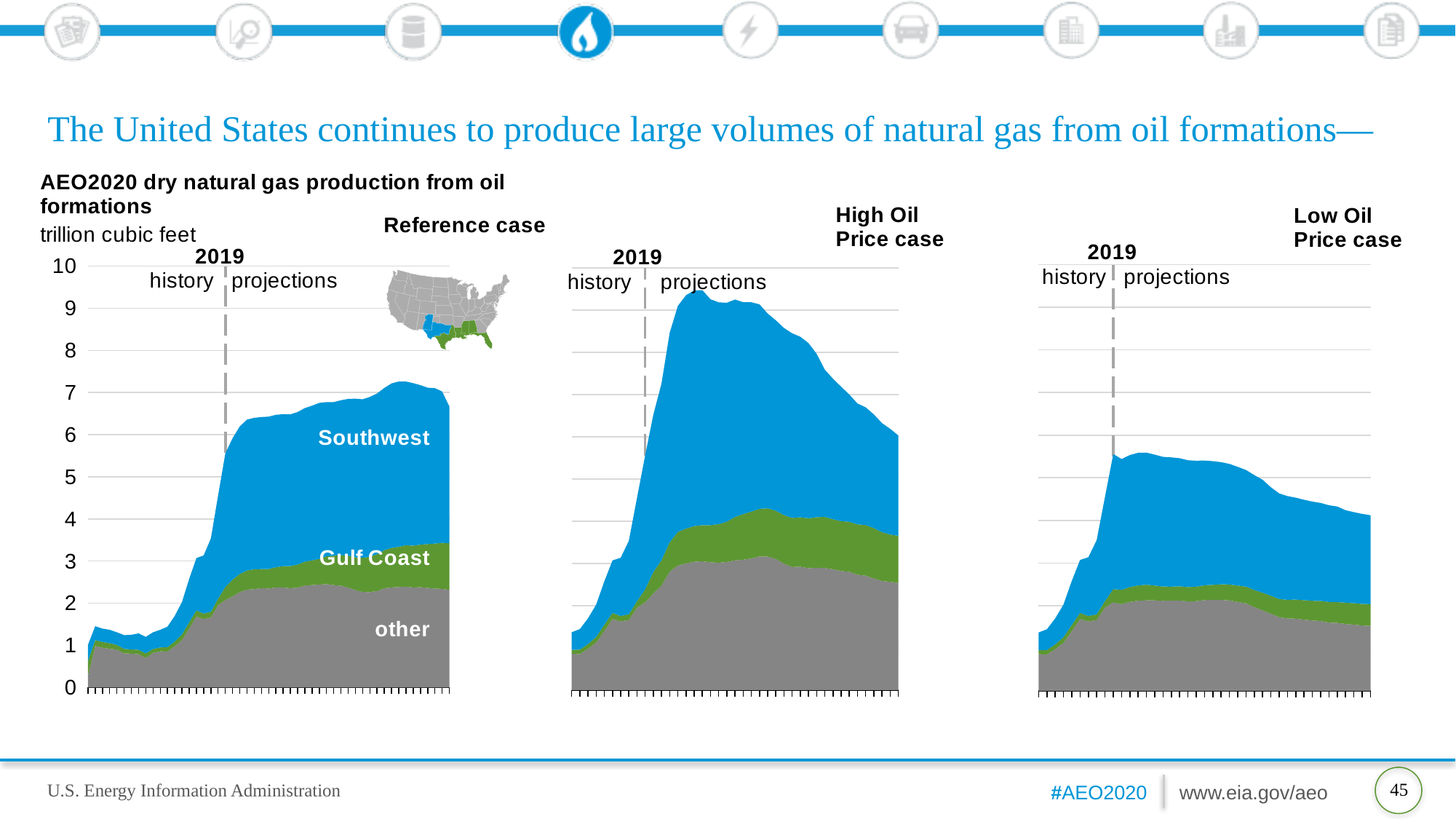
What kind of chart is used for the Reference case on this slide? stacked area chart How many series are stacked in each chart on this slide? 3 Which of the three cases has the lowest peak total production? Low Oil Price case In the Low Oil Price case chart, is the total production at the end of the projection period greater or less than 5 trillion cubic feet? less In the Low Oil Price case chart, is the peak total production greater or less than 6 trillion cubic feet? less What unit is shown on the y axis of the charts? trillion cubic feet In the Reference case chart, which series forms the bottom (grey) layer of the stack? other In the Low Oil Price case chart, does total production rise or fall over the projection period after 2019? fall In the High Oil Price case chart, does total production rise or fall after its peak in the projection period? fall Which of the three cases reaches the highest peak total production? High Oil Price case In the Reference case chart, is the peak total production greater or less than 6 trillion cubic feet? greater